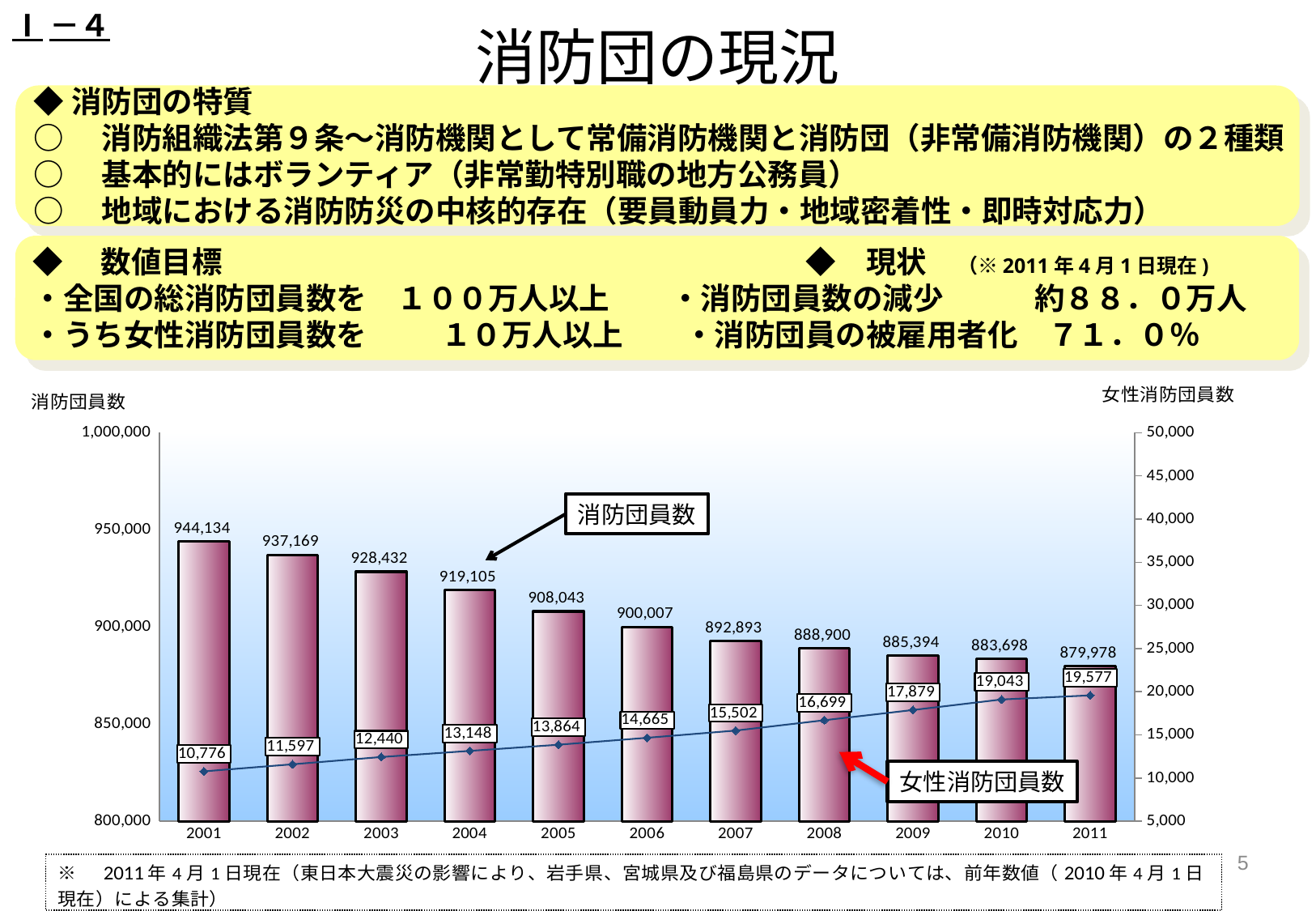
Which year has the lowest 女性消防団員数? 2001 How many years are shown on the x axis of the chart? 11 What is the value of 女性消防団員数 for 2005? 13,864 Which is larger, the 消防団員数 for 2004 or for 2008? 2004 What kind of chart is shown on the slide? Combined bar and line chart What is the difference in 消防団員数 between 2001 and 2011? 64,156 Does 消防団員数 rise or fall from 2001 to 2011? Fall What is the value of 消防団員数 for 2006? 900,007 What is the value of 消防団員数 (bar) for 2001? 944,134 By how much did 女性消防団員数 increase from 2001 to 2011? 8,801 Which year has the highest 消防団員数? 2001 What is the value of 女性消防団員数 (line) for 2011? 19,577